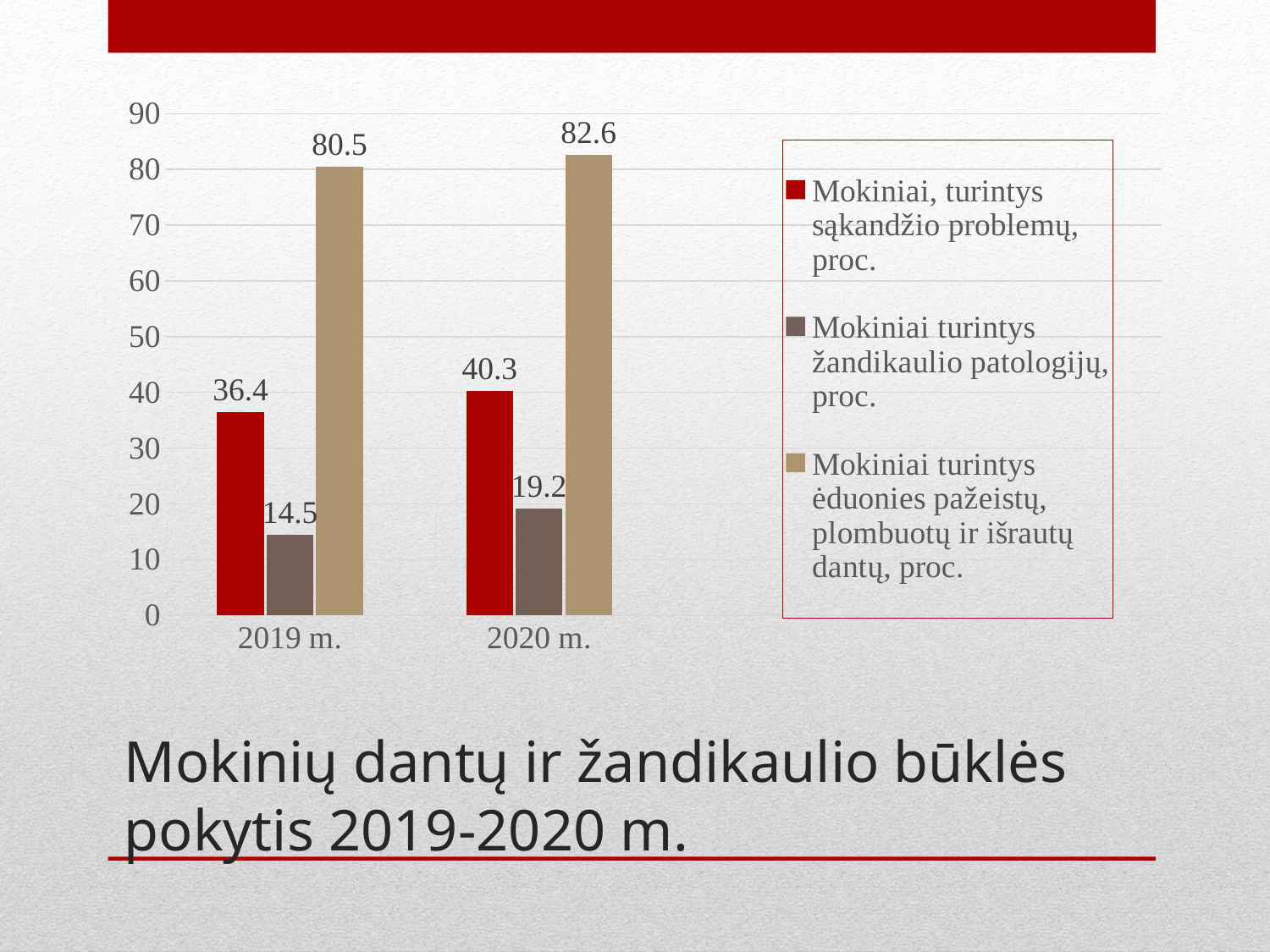
What is the value for 'Mokiniai, turintys sąkandžio problemų, proc.' in 2019 m.? 36.4 What kind of chart is shown on the slide? bar chart Which series has the highest value in 2020 m.? Mokiniai turintys ėduonies pažeistų, plombuotų ir išrautų dantų, proc. What is the value for 'Mokiniai turintys ėduonies pažeistų, plombuotų ir išrautų dantų, proc.' in 2019 m.? 80.5 Do the values for 'Mokiniai turintys ėduonies pažeistų, plombuotų ir išrautų dantų, proc.' rise or fall from 2019 m. to 2020 m.? rise How many categories are shown on the x axis? 2 How many series does the legend list? 3 What is the value for 'Mokiniai turintys žandikaulio patologijų, proc.' in 2020 m.? 19.2 Which is larger: the 2019 m. or the 2020 m. value for 'Mokiniai turintys žandikaulio patologijų, proc.'? 2020 m. Is the 2020 m. value for 'Mokiniai turintys ėduonies pažeistų, plombuotų ir išrautų dantų, proc.' greater or less than 80? greater Which series has the lowest value in 2019 m.? Mokiniai turintys žandikaulio patologijų, proc. What is the difference between the 2020 m. and 2019 m. values for 'Mokiniai, turintys sąkandžio problemų, proc.'? 3.9